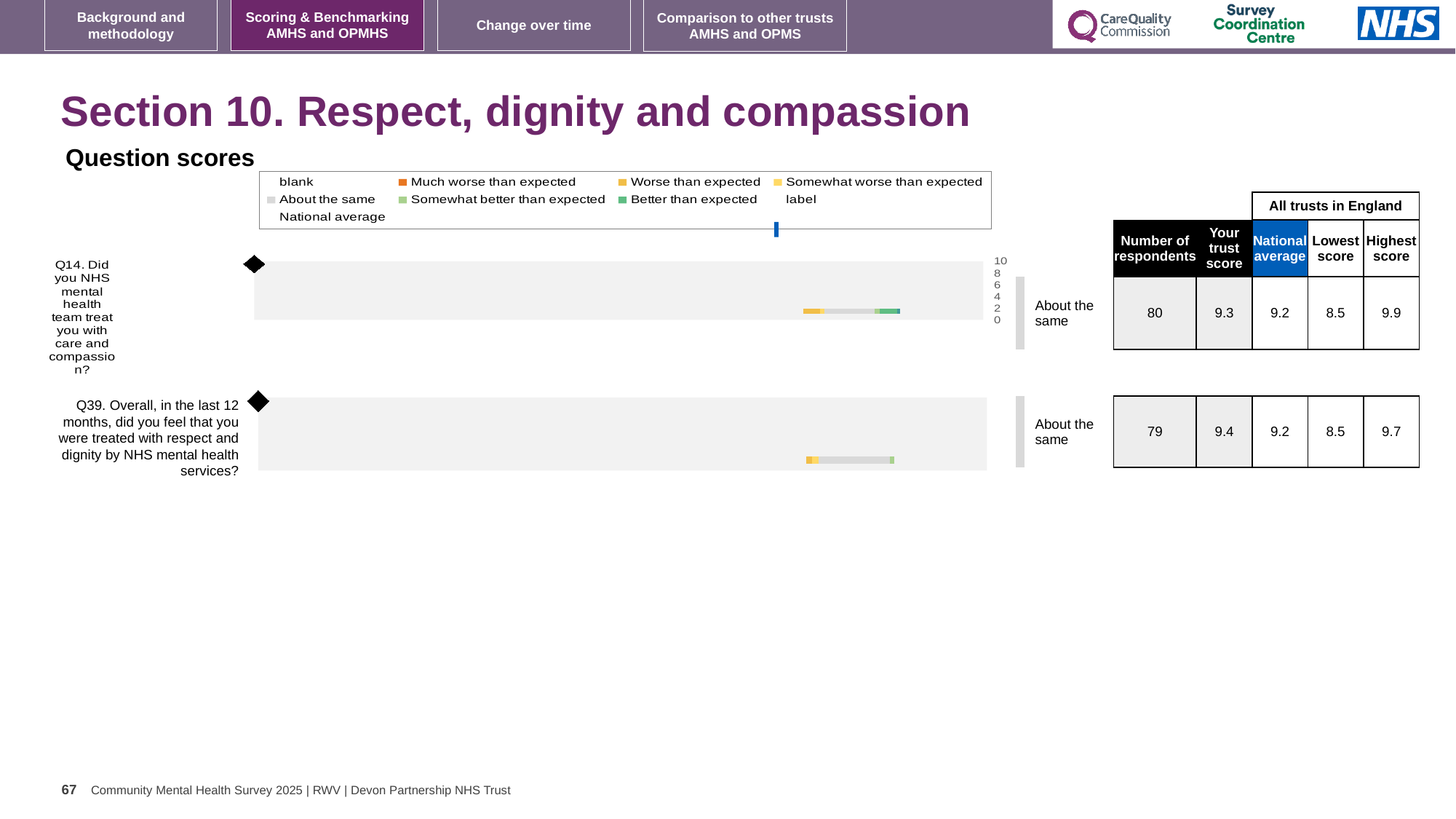
What is the trust score for Q39? 9.4 Which question has the higher trust score, Q14 or Q39? Q39 What is the lowest score across all trusts in England for Q39? 8.5 What is the number of respondents for Q14? 80 How many survey questions are plotted in the Question scores chart? 2 What is the highest score across all trusts in England for Q14? 9.9 What kind of chart is used to show the question scores? bar chart What is the difference between the trust score and the national average for Q14? 0.1 In the chart legend, what colour represents 'Much worse than expected'? orange Which question has the higher 'Highest score' value, Q14 or Q39? Q14 What benchmark category is shown for Q14? About the same What is the national average score for Q14? 9.2